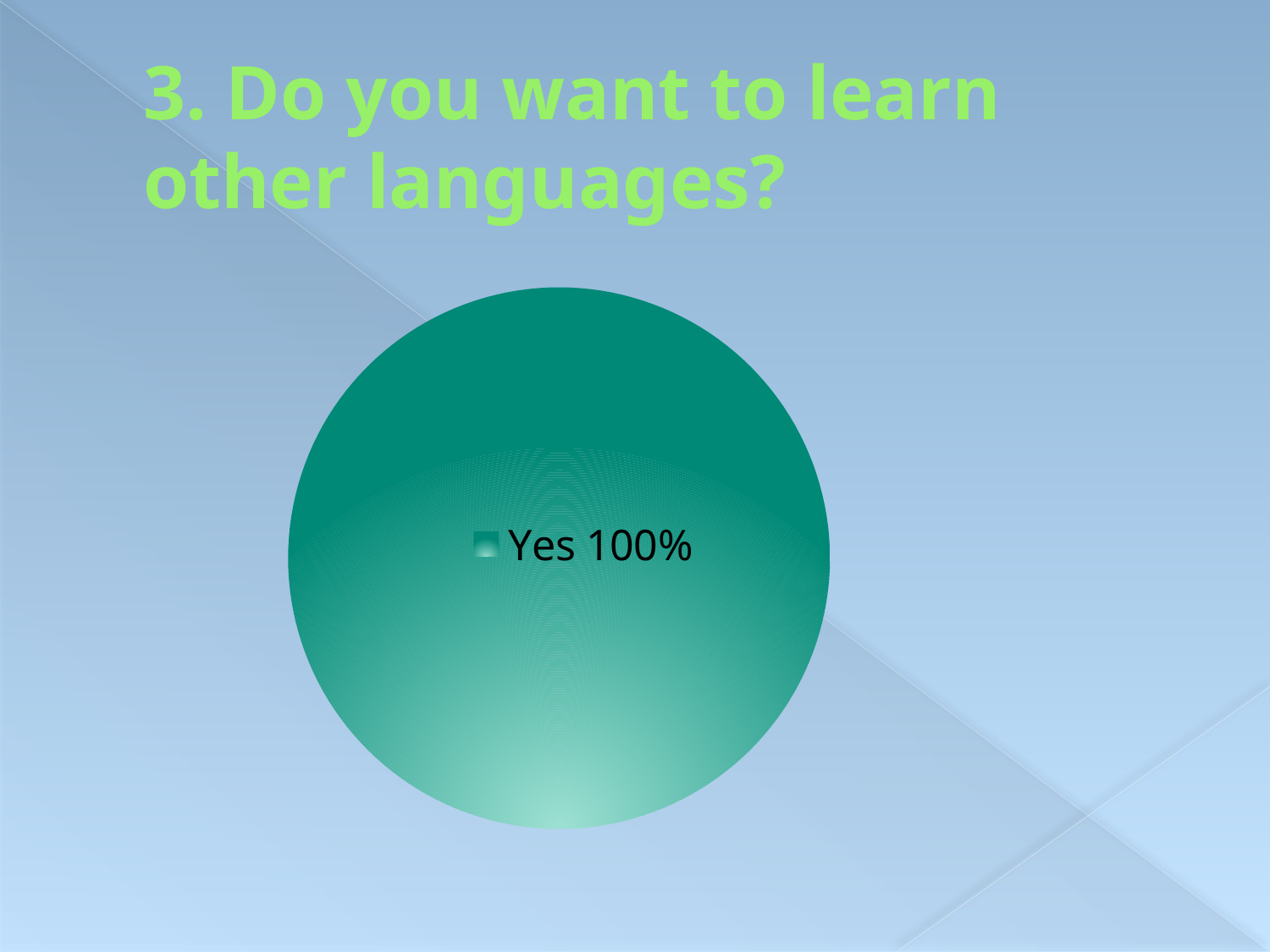
How many entries does the legend list? 1 How many slices does the pie chart have? 1 What is the legend entry shown on the pie chart? Yes 100% Which category is the largest slice of the pie chart? Yes 100% What kind of chart is shown on the slide? pie chart What share of the pie does the "Yes 100%" slice take up? 100% What is the title of the slide containing the pie chart? 3. Do you want to learn other languages?